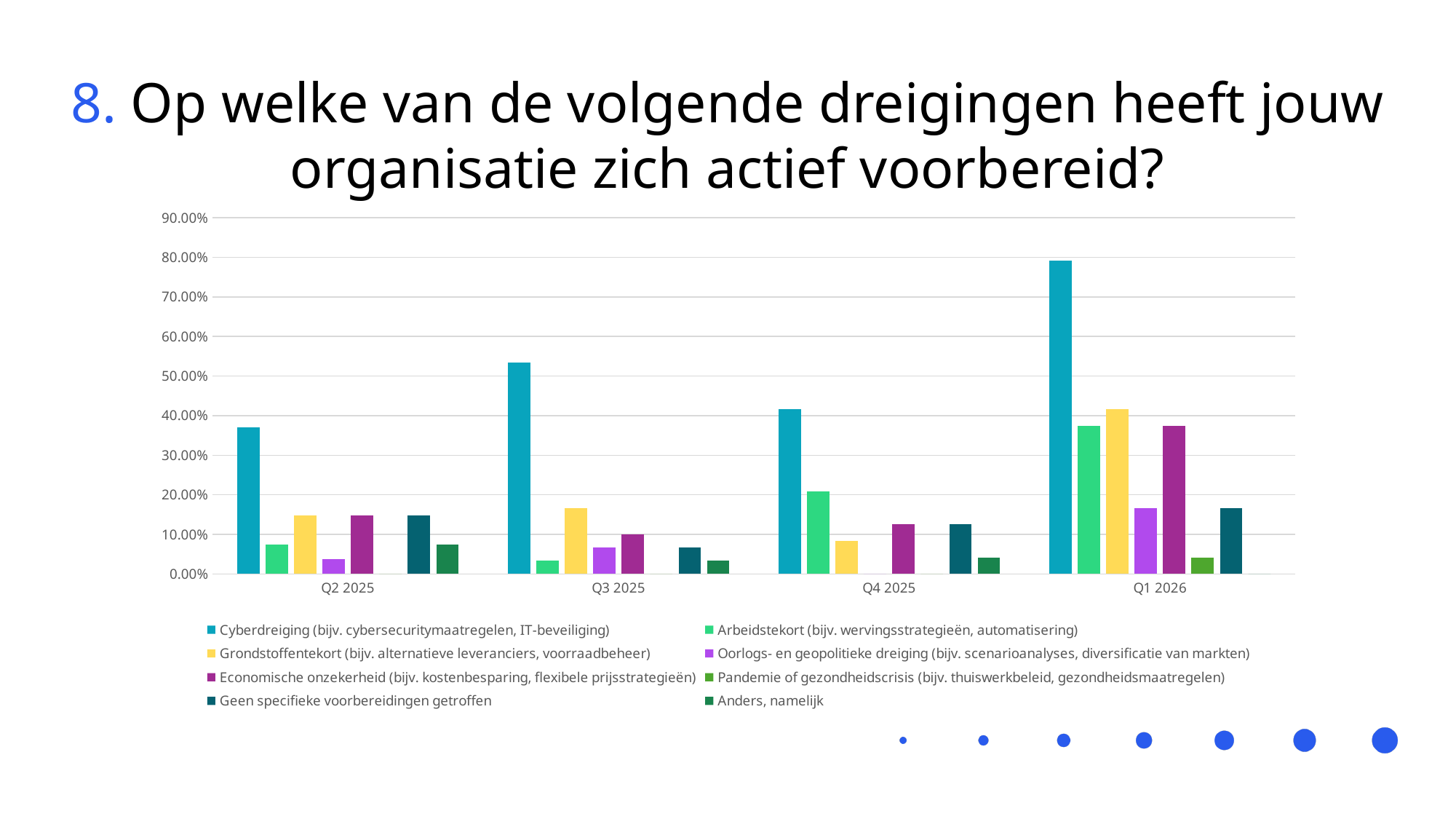
In Q4 2025, which is larger: Arbeidstekort or Grondstoffentekort? Arbeidstekort Is the value for Arbeidstekort in Q1 2026 greater or less than 30.00%? greater Is the value for Cyberdreiging in Q2 2025 greater or less than 40.00%? less How many quarters are shown on the x axis? 4 In which quarter is the bar for Cyberdreiging the lowest? Q2 2025 How many series does the legend list? 8 In which quarter is the bar for Cyberdreiging the highest? Q1 2026 In Q1 2026, which is larger: Grondstoffentekort or Oorlogs- en geopolitieke dreiging? Grondstoffentekort Is the value for Cyberdreiging in Q1 2026 greater or less than 70.00%? greater Does the value for Arbeidstekort rise or fall from Q3 2025 to Q1 2026? rise What kind of chart is shown on the slide? bar chart